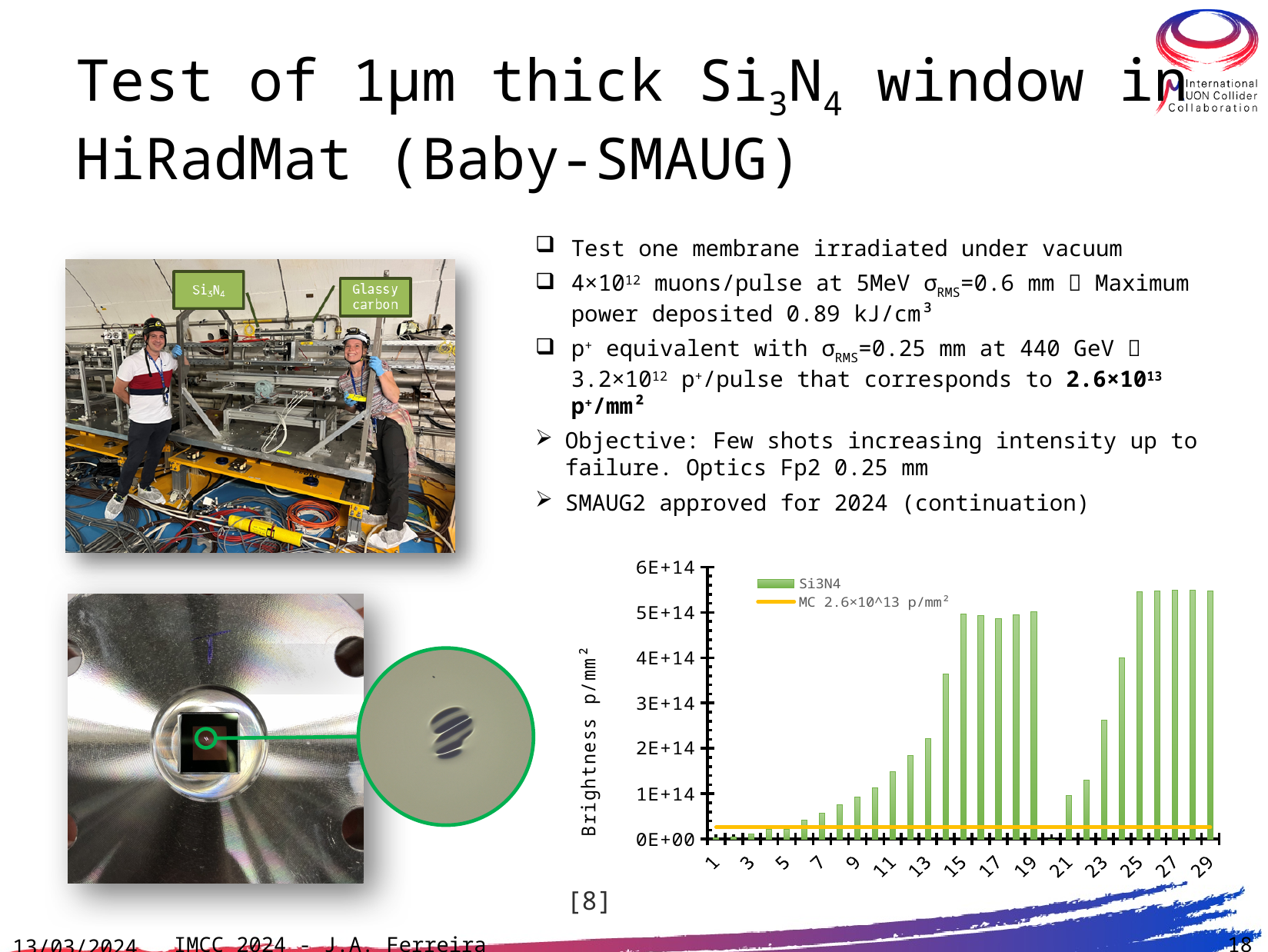
What kind of chart is shown on the slide? combination bar and line chart How many series does the chart legend list? 2 Which has the larger Si3N4 value, shot 15 or shot 5? shot 15 How many tick labels are shown on the chart's x axis? 15 What is the label of the chart's vertical axis? Brightness p/mm² What are the two entries in the chart legend? Si3N4 and MC 2.6×10^13 p/mm² Is the Si3N4 value for shot 5 greater or less than 1E+14? less Is the Si3N4 value for shot 14 greater or less than 3E+14? greater Is the Si3N4 value for shot 23 greater or less than 3E+14? less